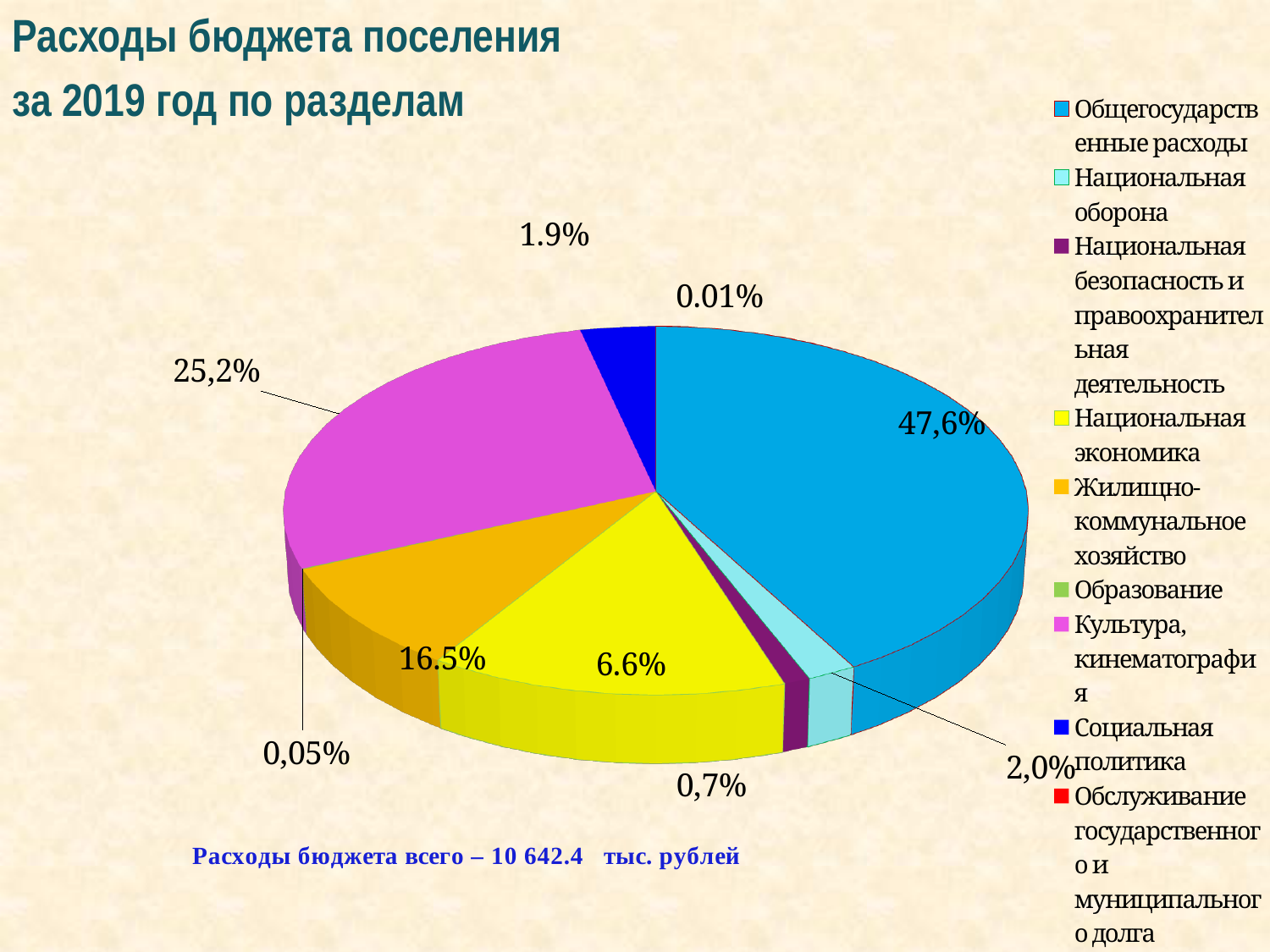
What is the title of the chart on the slide? Расходы бюджета поселения за 2019 год по разделам What is the difference between the share for Общегосударственные расходы and the share for Культура, кинематография? 22,4% According to the text below the chart, what is the total budget expenditure? 10 642.4 тыс. рублей Which category has the largest share of the pie? Общегосударственные расходы What share of the pie does Общегосударственные расходы have? 47,6% What share of the pie does Жилищно-коммунальное хозяйство have? 16.5% What share of the pie does Культура, кинематография have? 25,2% How many categories does the legend of the pie chart list? 9 What share of the pie does Национальная экономика have? 6.6% What share of the pie does Национальная оборона have? 2,0% What type of chart is shown on the slide? Pie chart